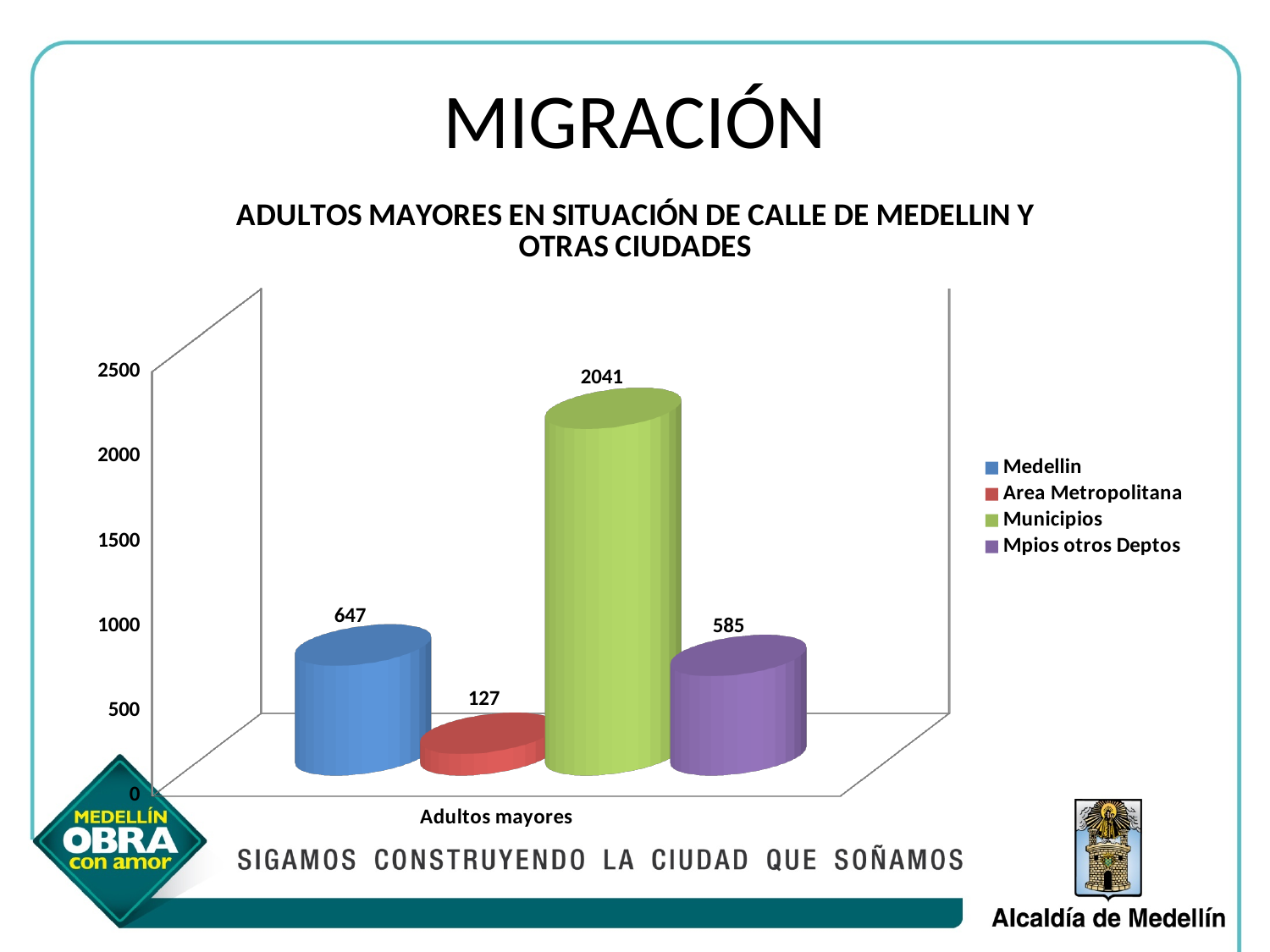
How many series does the legend list? 4 Which is larger, the value for Medellin or the value for Area Metropolitana? Medellin What is the title of the chart? ADULTOS MAYORES EN SITUACIÓN DE CALLE DE MEDELLIN Y OTRAS CIUDADES What is the value for Medellin? 647 Which series has the highest value? Municipios What is the difference between the values for Municipios and Medellin? 1394 Which series has the lowest value? Area Metropolitana What is the value for Area Metropolitana? 127 What is the value for Municipios? 2041 What is the value for Mpios otros Deptos? 585 What kind of chart is shown? bar chart What is the difference between the values for Medellin and Mpios otros Deptos? 62